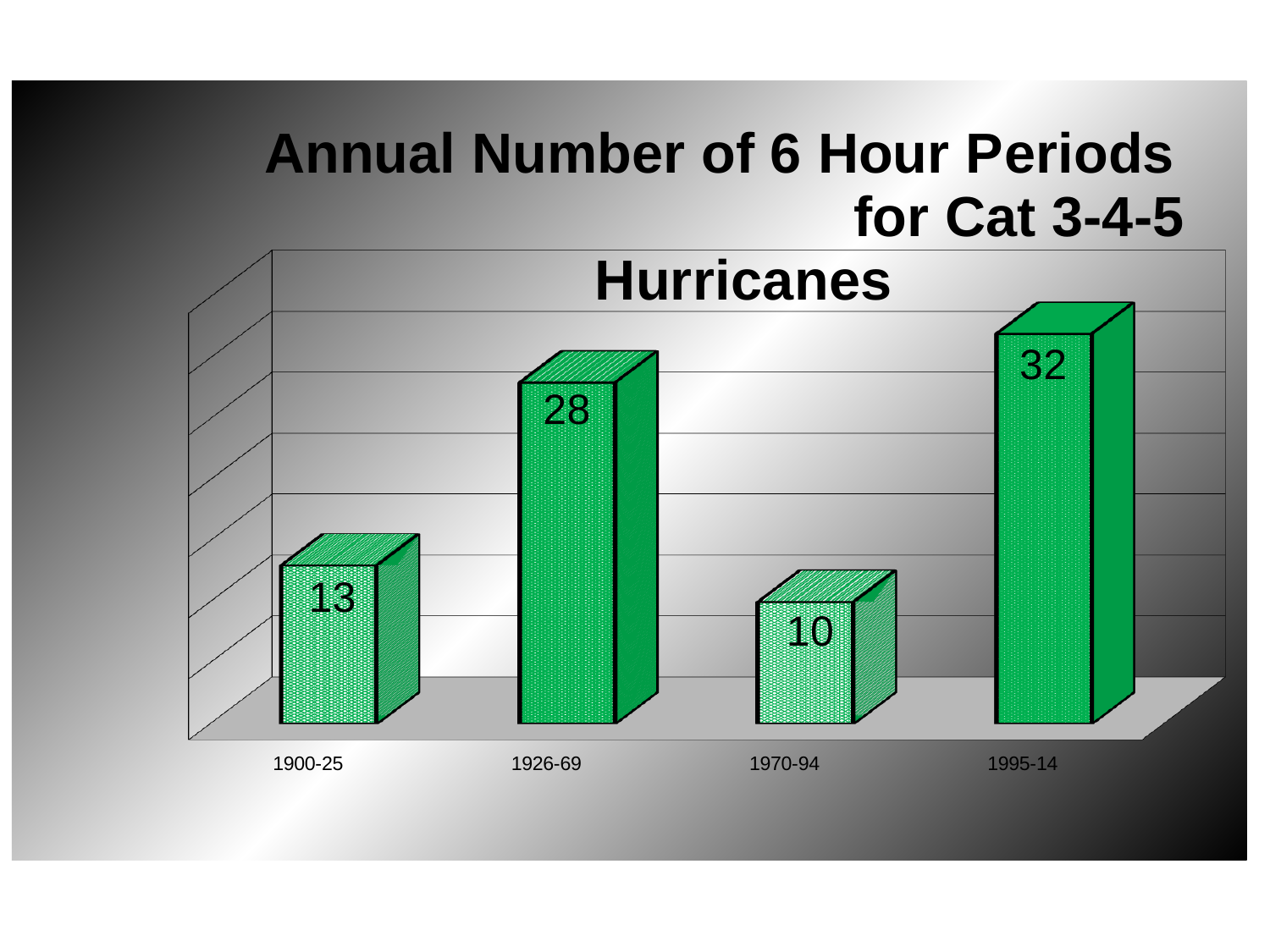
What is the value for 1900-25? 13 What is the title of the chart? Annual Number of 6 Hour Periods for Cat 3-4-5 Hurricanes What is the difference between the values for 1900-25 and 1970-94? 3 Which period has the lowest value? 1970-94 What is the value for 1995-14? 32 Which is larger, the value for 1926-69 or the value for 1900-25? 1926-69 What is the value for 1926-69? 28 What is the difference between the values for 1995-14 and 1926-69? 4 What is the value for 1970-94? 10 What kind of chart is this? bar chart How many periods are shown on the x axis? 4 Which period has the highest value? 1995-14